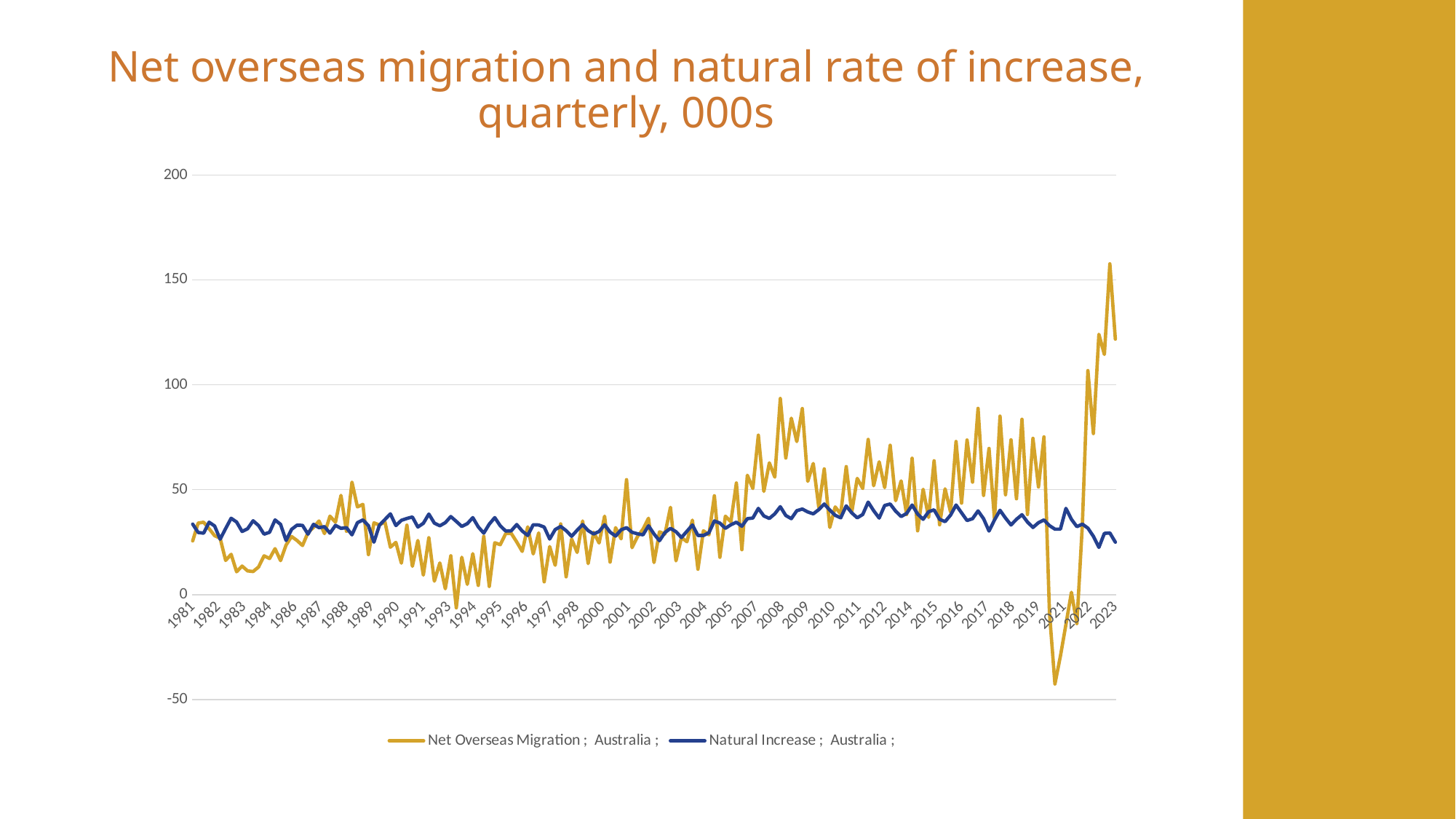
Is the peak value of Net Overseas Migration greater or less than 100? greater Around which year does Net Overseas Migration reach its highest point? 2023 Does Natural Increase rise or fall between 2019 and 2023? fall Which series reaches the highest value on the chart? Net Overseas Migration ; Australia ; How many series does the legend list? 2 Is the highest value of Natural Increase greater or less than 50? less What is the title of the chart? Net overseas migration and natural rate of increase, quarterly, 000s Which series is larger around 2021: Net Overseas Migration or Natural Increase? Natural Increase Is the lowest value of Net Overseas Migration greater or less than 0? less What kind of chart is shown on the slide? Line chart Which series is drawn in dark blue? Natural Increase ; Australia ;